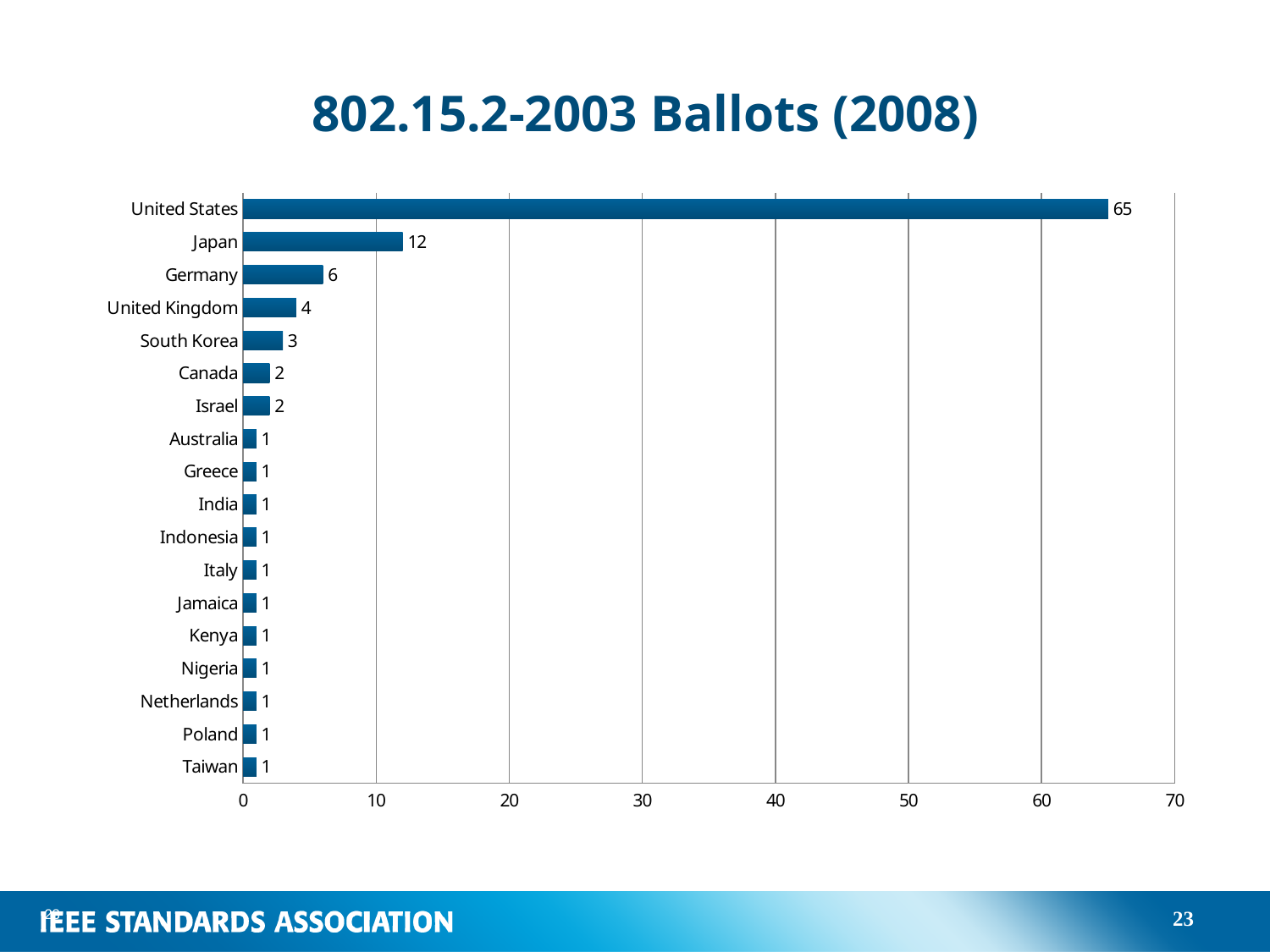
What is the value for Germany? 6 What is the difference between the values for Japan and Germany? 6 Is the value for the United States greater or less than 60? greater What is the value for Japan? 12 What is the title of the chart? 802.15.2-2003 Ballots (2008) What is the value for the United States? 65 Which has a larger value, the United Kingdom or South Korea? United Kingdom What is the value for South Korea? 3 Which country has the highest value? United States What is the difference between the values for the United States and Japan? 53 How many countries are shown in the chart? 18 What kind of chart is shown on the slide? Bar chart